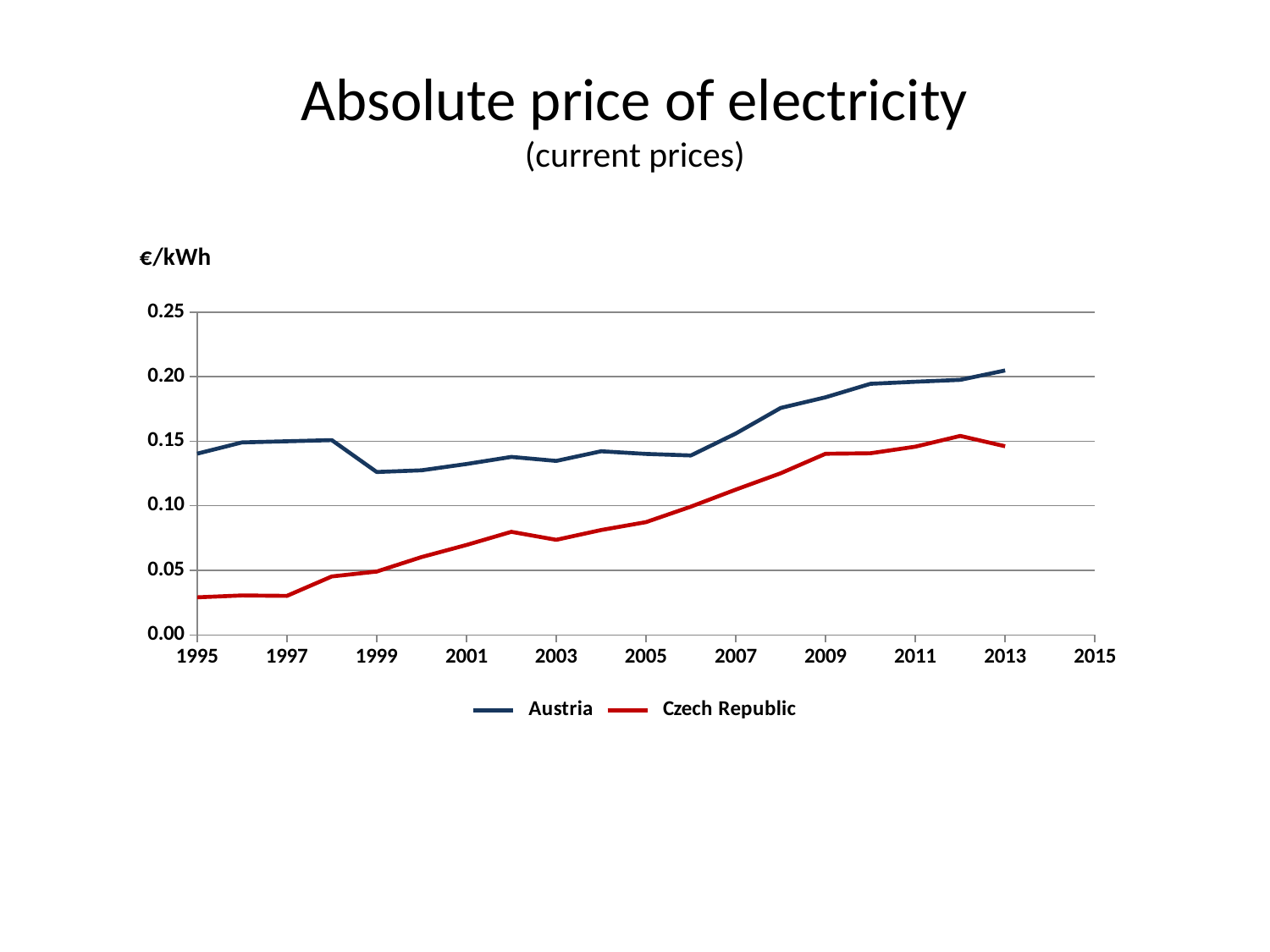
In 2005, which series has the higher value, Austria or Czech Republic? Austria Which two series are shown in the legend? Austria and Czech Republic What kind of chart is shown on the slide? line chart Is the value for the Czech Republic in 1995 greater or less than 0.05? less How many series does the legend list? 2 Is the value for the Czech Republic in 2009 greater or less than 0.10? greater Is the value for the Czech Republic in 2003 greater or less than 0.10? less Does the Czech Republic series generally rise or fall from 1995 to 2013? rise In which year does the Czech Republic series reach its highest value? 2012 What unit is shown on the y axis of the chart? €/kWh